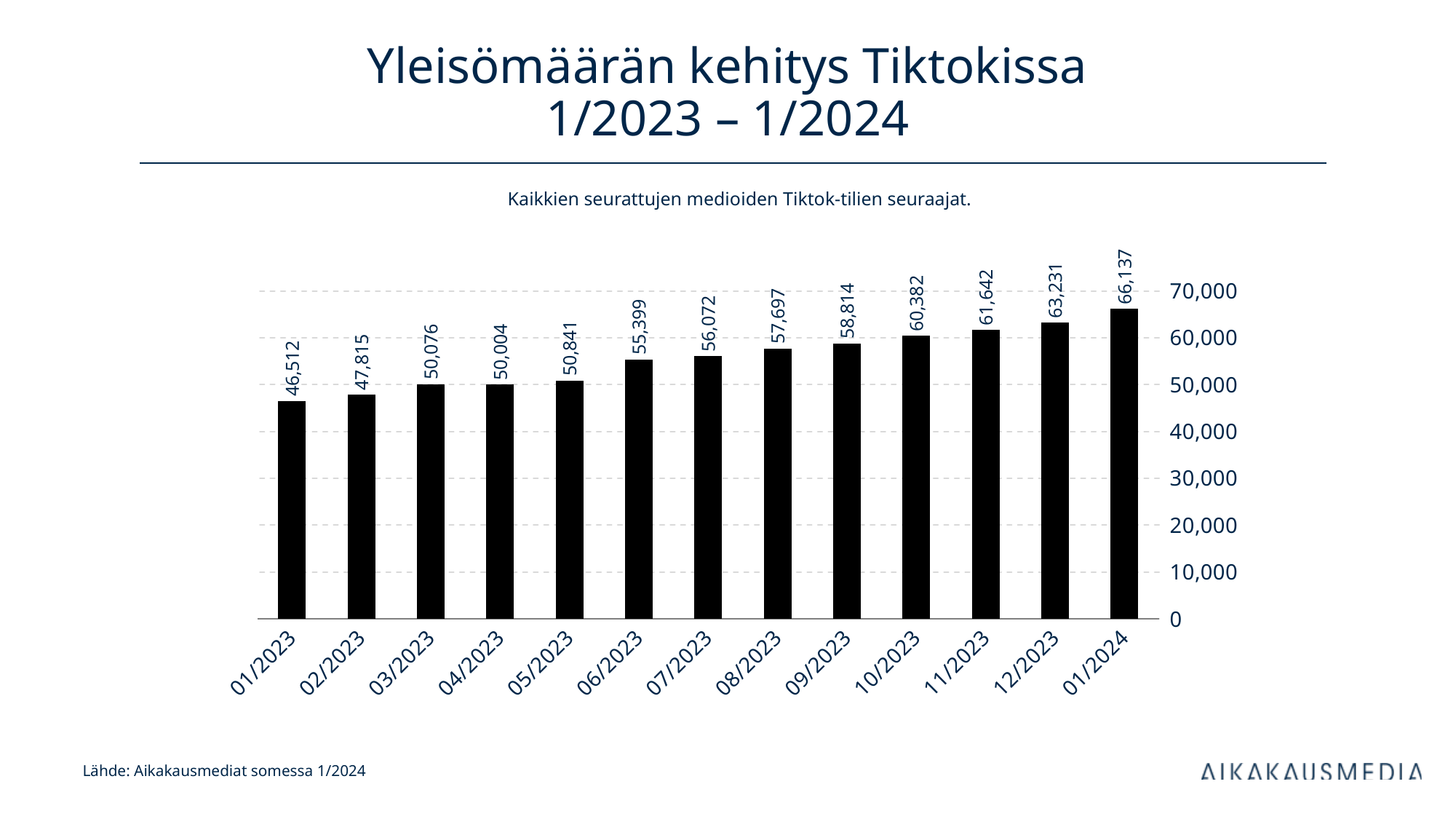
Which is larger, the value for 03/2023 or the value for 04/2023? 03/2023 What is the value for 01/2024? 66,137 What is the value for 01/2023? 46,512 What is the title of the chart? Yleisömäärän kehitys Tiktokissa 1/2023 – 1/2024 How many months are shown on the x axis? 13 Which month has the highest value? 01/2024 What is the difference between the values for 12/2023 and 11/2023? 1,589 What is the difference between the values for 01/2024 and 01/2023? 19,625 Is the value for 09/2023 greater or less than 60,000? less What is the value for 06/2023? 55,399 What kind of chart is shown on the slide? bar chart Which month has the lowest value? 01/2023